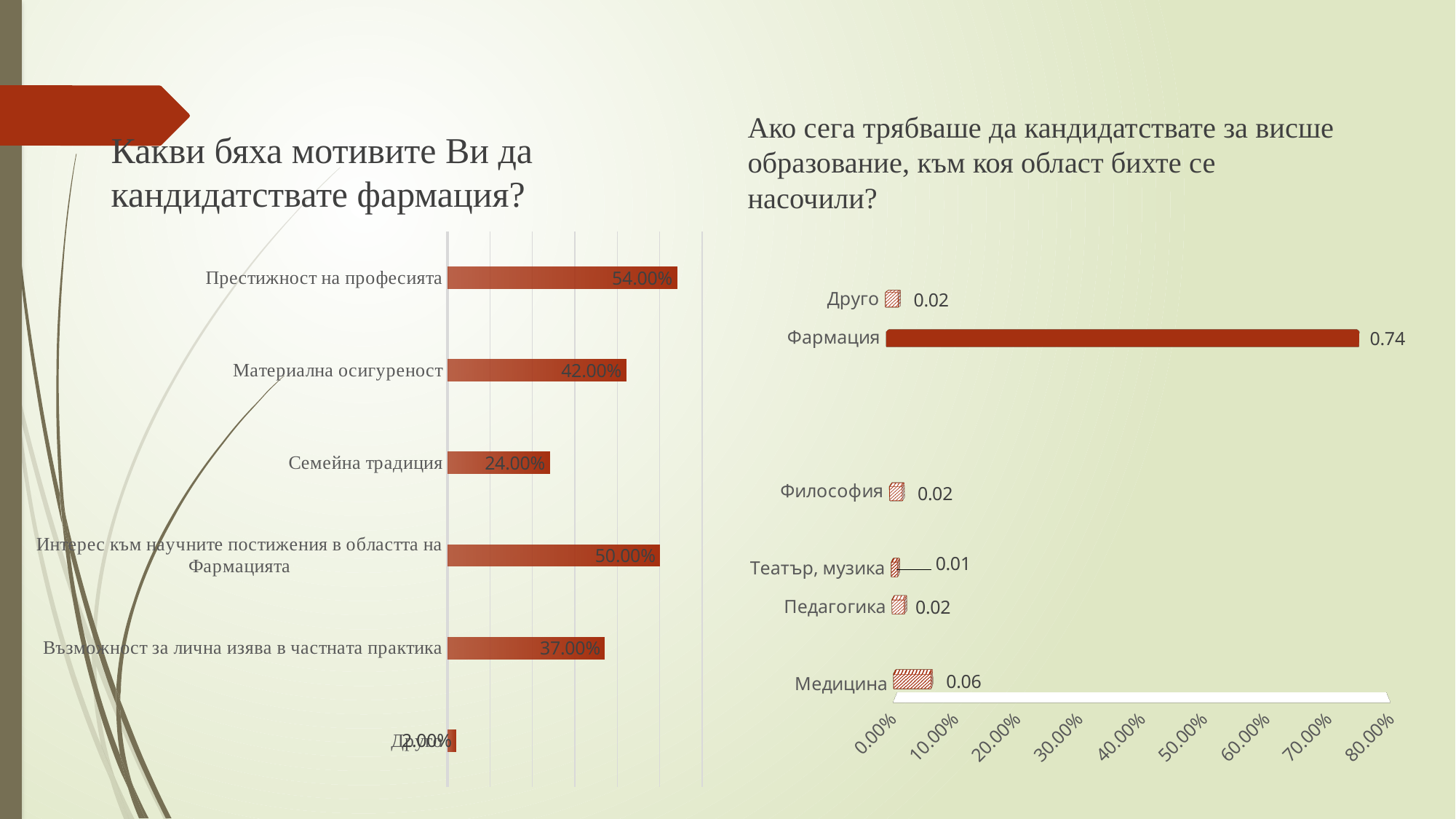
In the left chart 'Какви бяха мотивите Ви да кандидатствате фармация?', which is larger: 'Интерес към научните постижения в областта на Фармацията' or 'Материална осигуреност'? Интерес към научните постижения в областта на Фармацията In the left chart 'Какви бяха мотивите Ви да кандидатствате фармация?', what is the difference between 'Материална осигуреност' and 'Възможност за лична изява в частната практика'? 5.00% In the right chart 'Ако сега трябваше да кандидатствате за висше образование...', what is the value for 'Медицина'? 0.06 What type of chart is the right chart 'Ако сега трябваше да кандидатствате за висше образование, към коя област бихте се насочили?'? Bar chart In the right chart 'Ако сега трябваше да кандидатствате за висше образование...', what is the difference between 'Фармация' and 'Медицина'? 0.68 In the left chart 'Какви бяха мотивите Ви да кандидатствате фармация?', what is the value for 'Престижност на професията'? 54.00% In the right chart 'Ако сега трябваше да кандидатствате за висше образование...', which category has the lowest value? Театър, музика How many categories are shown in the right chart 'Ако сега трябваше да кандидатствате за висше образование...'? 6 In the right chart 'Ако сега трябваше да кандидатствате за висше образование...', what is the value for 'Фармация'? 0.74 In the left chart 'Какви бяха мотивите Ви да кандидатствате фармация?', what is the value for 'Семейна традиция'? 24.00% How many categories are shown in the left chart 'Какви бяха мотивите Ви да кандидатствате фармация?'? 6 In the left chart 'Какви бяха мотивите Ви да кандидатствате фармация?', which category has the highest value? Престижност на професията